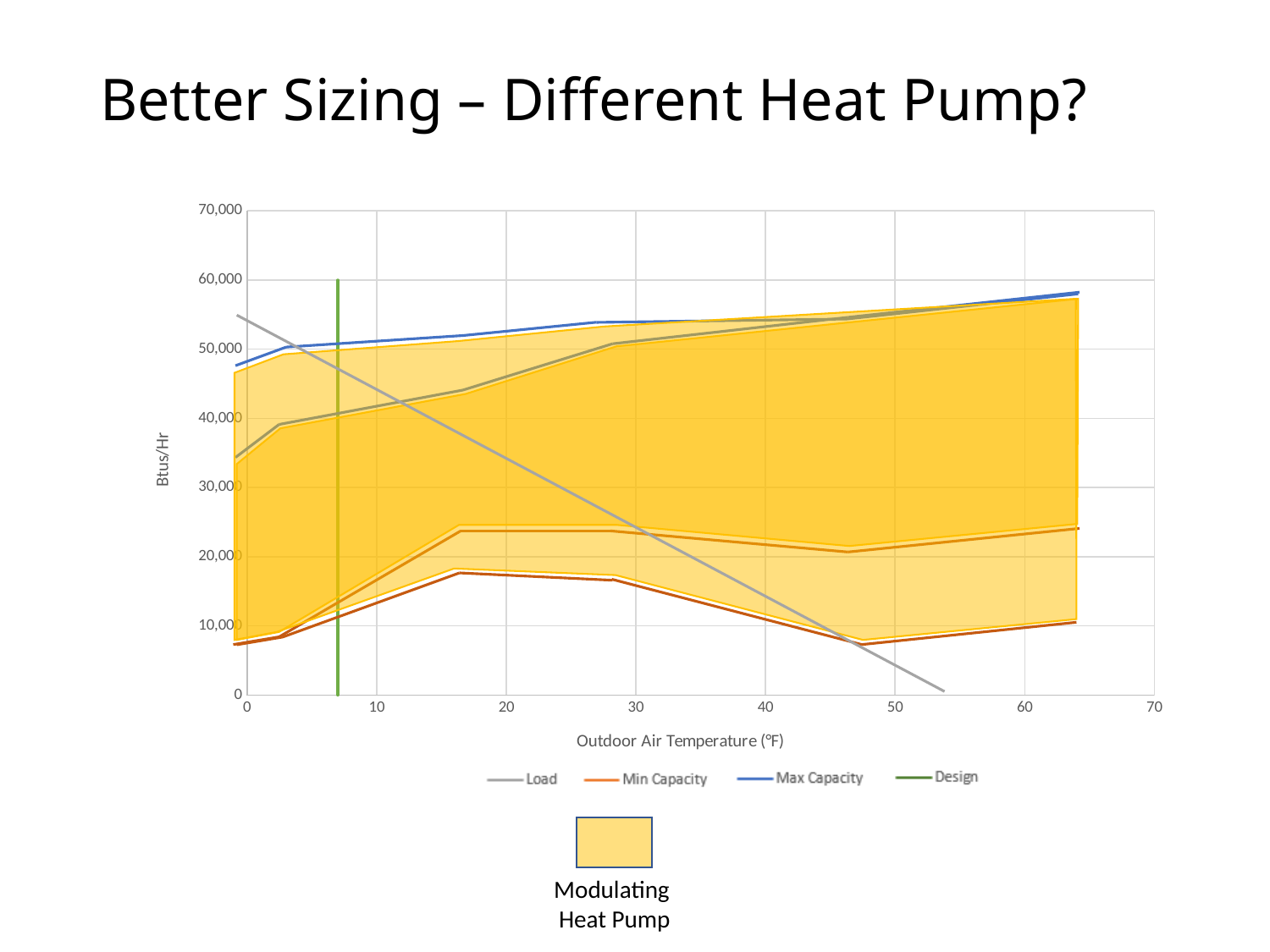
Is the Load value at 0°F greater or less than 50,000 Btus/Hr? greater What is the title of the vertical axis of the chart? Btus/Hr Is the Load value at 50°F greater or less than 10,000 Btus/Hr? less How many series does the chart legend list? 4 At 64°F, which is larger: the Max Capacity value or the Min Capacity value? Max Capacity What kind of chart is shown on the slide? line chart Is the Min Capacity value at 64°F greater or less than 30,000 Btus/Hr? less Does the Load series rise or fall as outdoor air temperature increases? fall At 0°F, which is larger: the Load value or the Max Capacity value? Load Does the Max Capacity series rise or fall as outdoor air temperature increases? rise What are the series names listed in the chart legend? Load, Min Capacity, Max Capacity, Design